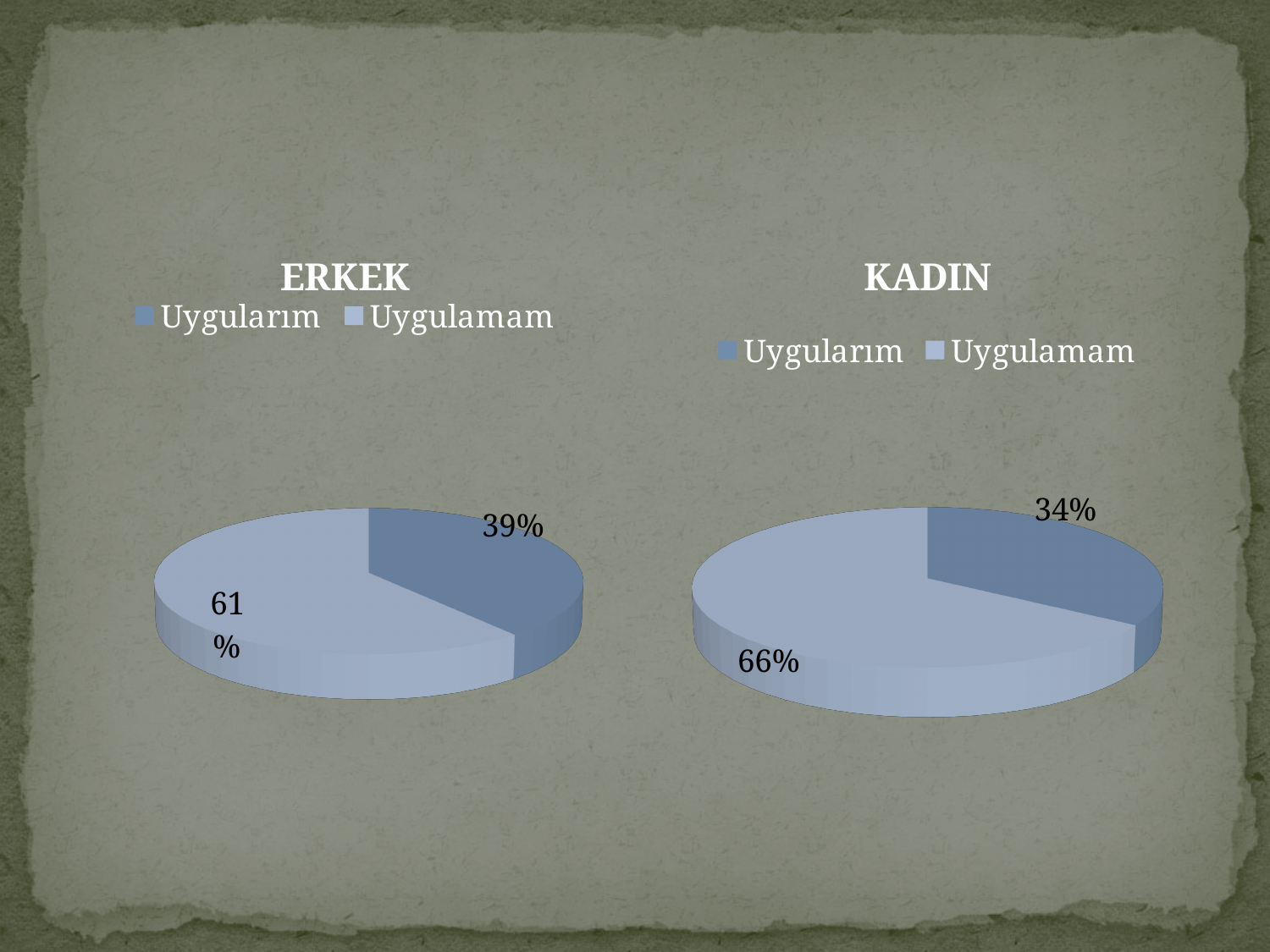
Which is larger: the Uygularım share in the ERKEK chart or the Uygularım share in the KADIN chart? ERKEK In the ERKEK chart, what share does Uygularım have? 39% What kind of chart is the KADIN chart? Pie chart In the ERKEK chart, which slice is the largest? Uygulamam How many slices does the ERKEK chart have? 2 In the ERKEK chart, what is the difference between the Uygulamam and Uygularım shares? 22% What are the two legend entries in the KADIN chart? Uygularım and Uygulamam In the KADIN chart, which slice is the smallest? Uygularım In the KADIN chart, what share does Uygularım have? 34% In the ERKEK chart, what share does Uygulamam have? 61% In the KADIN chart, what is the difference between the Uygulamam and Uygularım shares? 32% In the KADIN chart, what share does Uygulamam have? 66%